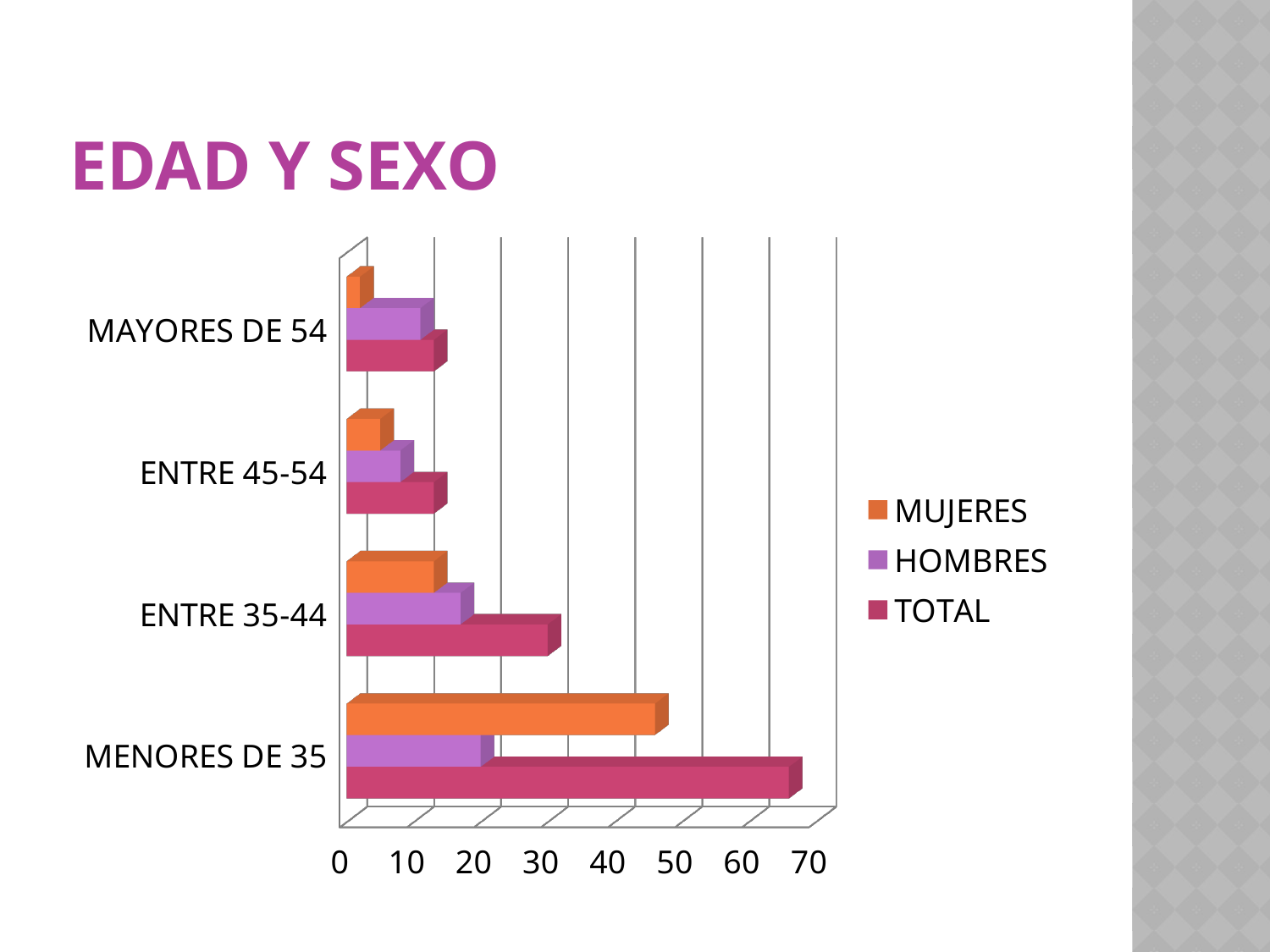
Which age category has the highest TOTAL value? MENORES DE 35 Is the TOTAL value for MENORES DE 35 greater or less than 60? greater Which age category has the lowest MUJERES value? MAYORES DE 54 For MAYORES DE 54, which is larger, the MUJERES value or the HOMBRES value? HOMBRES Is the MUJERES value for MENORES DE 35 greater or less than 40? greater Which colour represents the TOTAL series in the legend? magenta/pink What kind of chart is shown on the slide? bar chart How many age categories are shown on the chart? 4 Is the TOTAL value for ENTRE 45-54 greater or less than 20? less What is the title of the slide? EDAD Y SEXO How many series does the legend list? 3 For MENORES DE 35, which is larger, the MUJERES value or the HOMBRES value? MUJERES